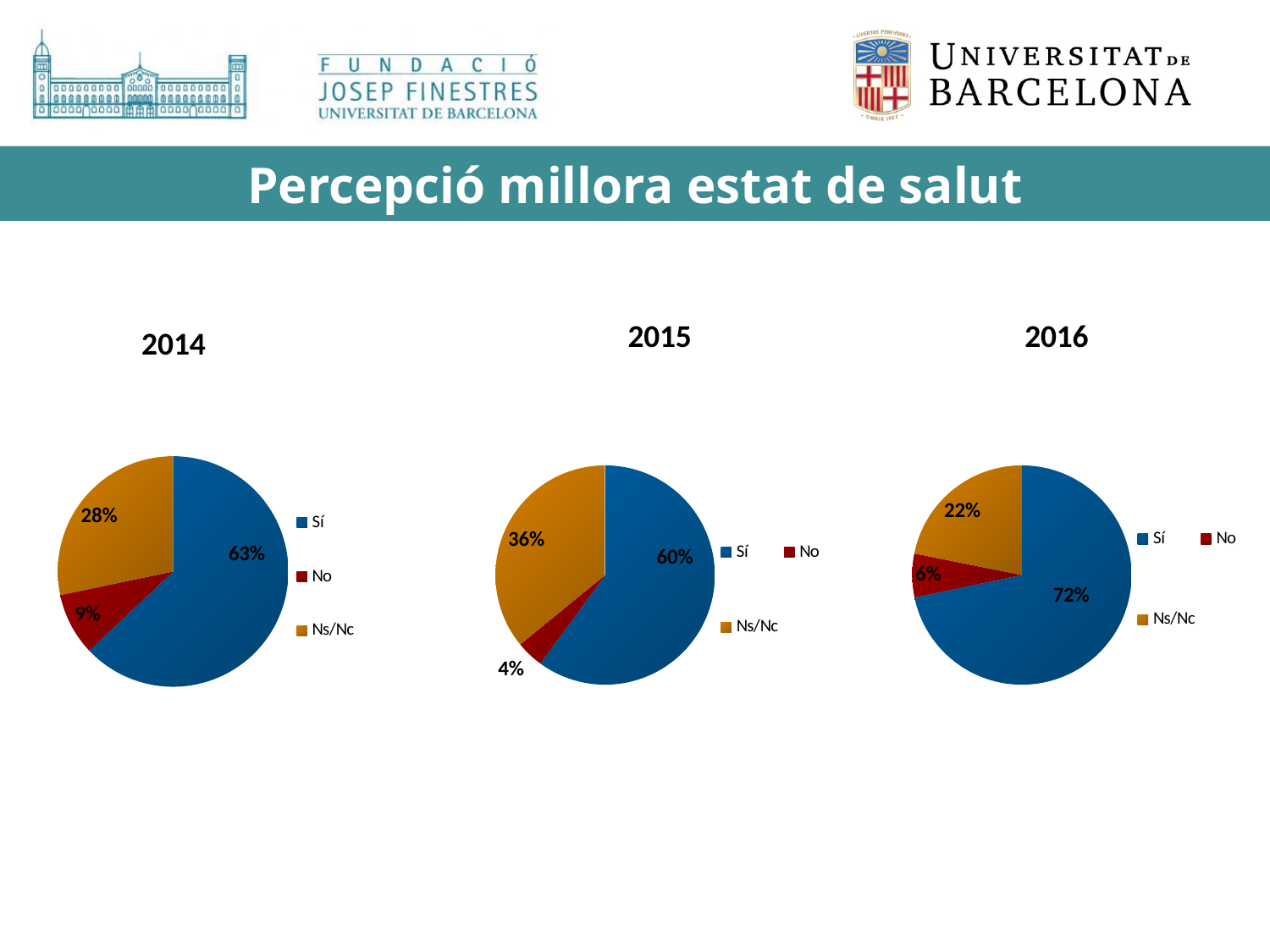
What type of chart is used for the 2014 data? Pie chart In the 2014 pie chart, what percentage is shown for Sí? 63% Across the 2014, 2015 and 2016 pie charts, what is the difference between the Sí percentage in 2016 and in 2014? 9% In the 2016 pie chart, which category has the largest slice? Sí How many slices does the 2015 pie chart have? 3 In the 2016 pie chart, what percentage is shown for No? 6% How many entries does the legend of the 2016 pie chart list? 3 In the 2014 pie chart, which is larger, the Ns/Nc slice or the No slice? Ns/Nc In the 2015 pie chart, what is the difference between the Sí and Ns/Nc percentages? 24% In the 2015 pie chart, what percentage is shown for Ns/Nc? 36% What colour represents Ns/Nc in the pie charts? Orange In the 2014 pie chart, which category has the smallest slice? No